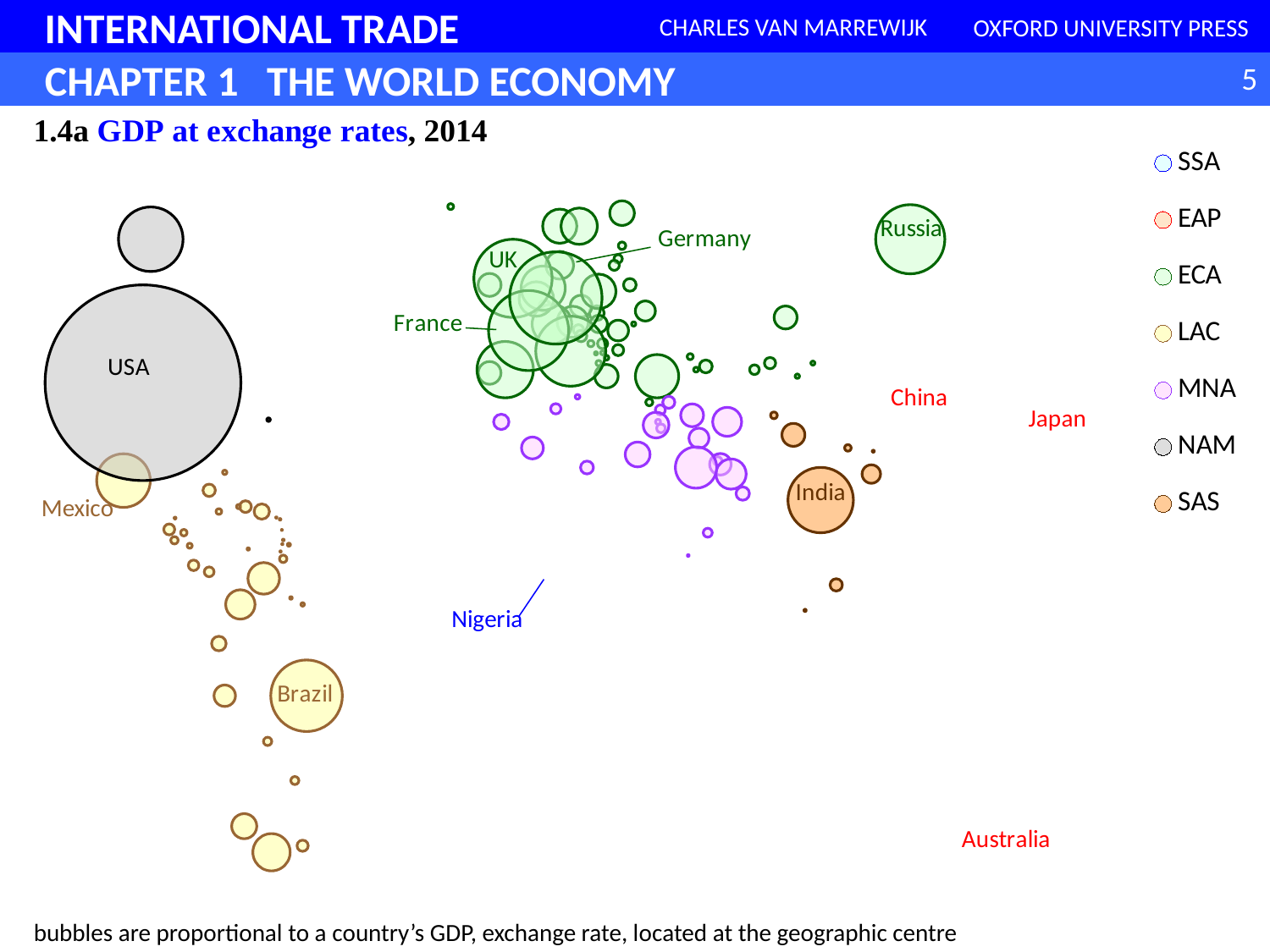
How many countries are labelled by name on the chart? 12 Which legend region does the USA bubble belong to, based on its colour? NAM Which bubble is larger, Brazil or Mexico? Brazil What kind of chart is shown on the slide? bubble chart Which country has the largest bubble on the chart? USA How many regions does the legend list? 7 Which bubble is larger, USA or Brazil? USA Which year does the chart show GDP at exchange rates for? 2014 Which bubble is larger, USA or India? USA What is the title of the chart? 1.4a GDP at exchange rates, 2014